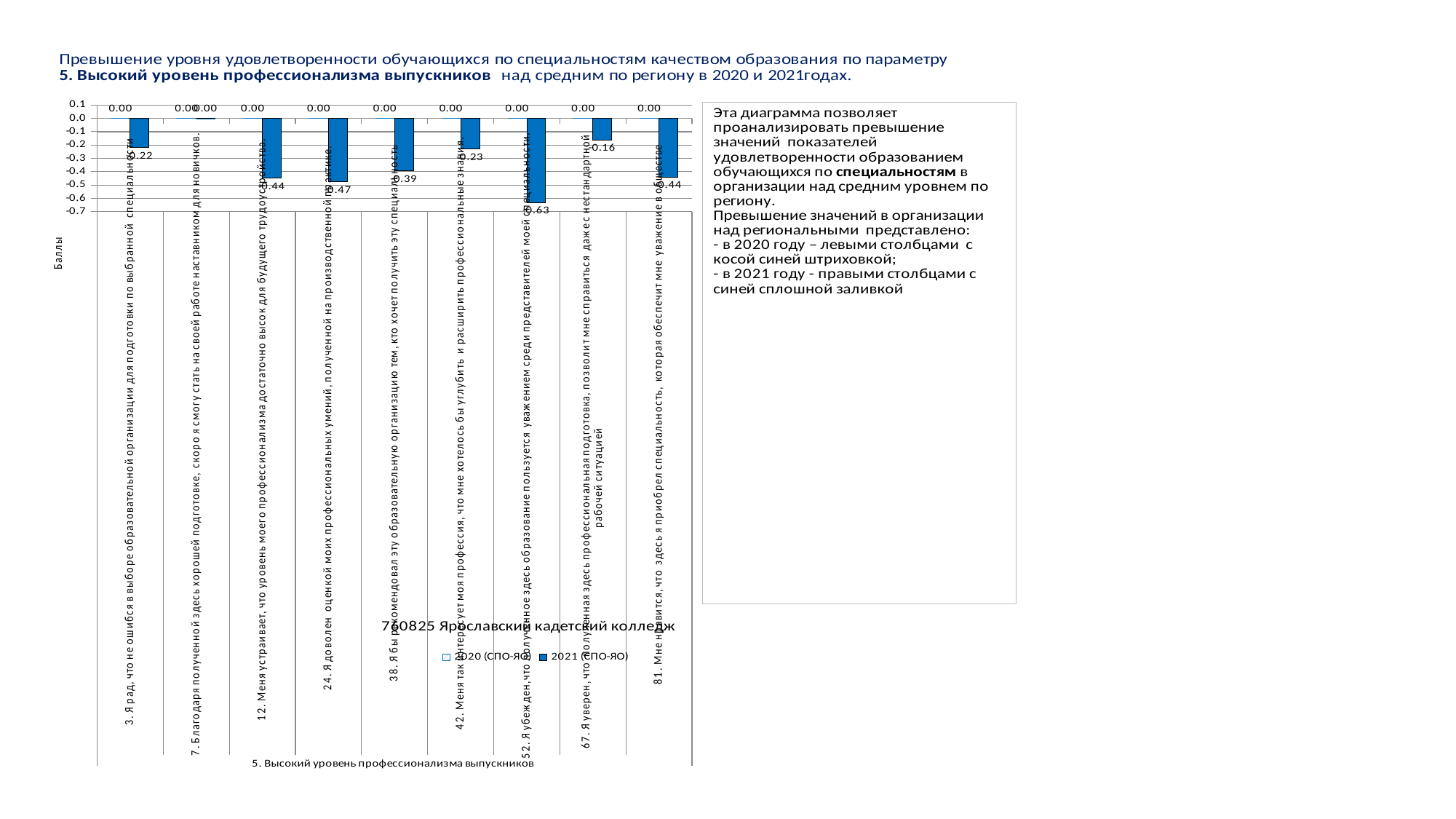
Which statement has the lowest 2021 (СПО-ЯО) value? 52. Я убежден, что полученное здесь образование пользуется уважением среди представителей моей специальности What label is shown on the vertical axis of the chart? Баллы Which has the larger 2021 (СПО-ЯО) value: statement 42 or statement 12? statement 42 What is the difference between the 2021 (СПО-ЯО) values for statement 24 (-0.47) and statement 38 (-0.39)? 0.08 What is the 2020 (СПО-ЯО) value for statement 24 ("Я доволен оценкой моих профессиональных умений...")? 0.00 What is the 2021 (СПО-ЯО) value for statement 52 ("Я убежден, что полученное здесь образование пользуется уважением...")? -0.63 What is the title printed on the chart? 760825 Ярославский кадетский колледж How many series does the chart legend list? 2 How many statement categories are plotted along the x axis of the chart? 9 What kind of chart is shown on the slide? bar chart What is the 2021 (СПО-ЯО) value for statement 67 ("Я уверен, что полученная здесь профессиональная подготовка...")? -0.16 What is the 2021 (СПО-ЯО) value for statement 3 ("Я рад, что не ошибся в выборе образовательной организации...")? -0.22